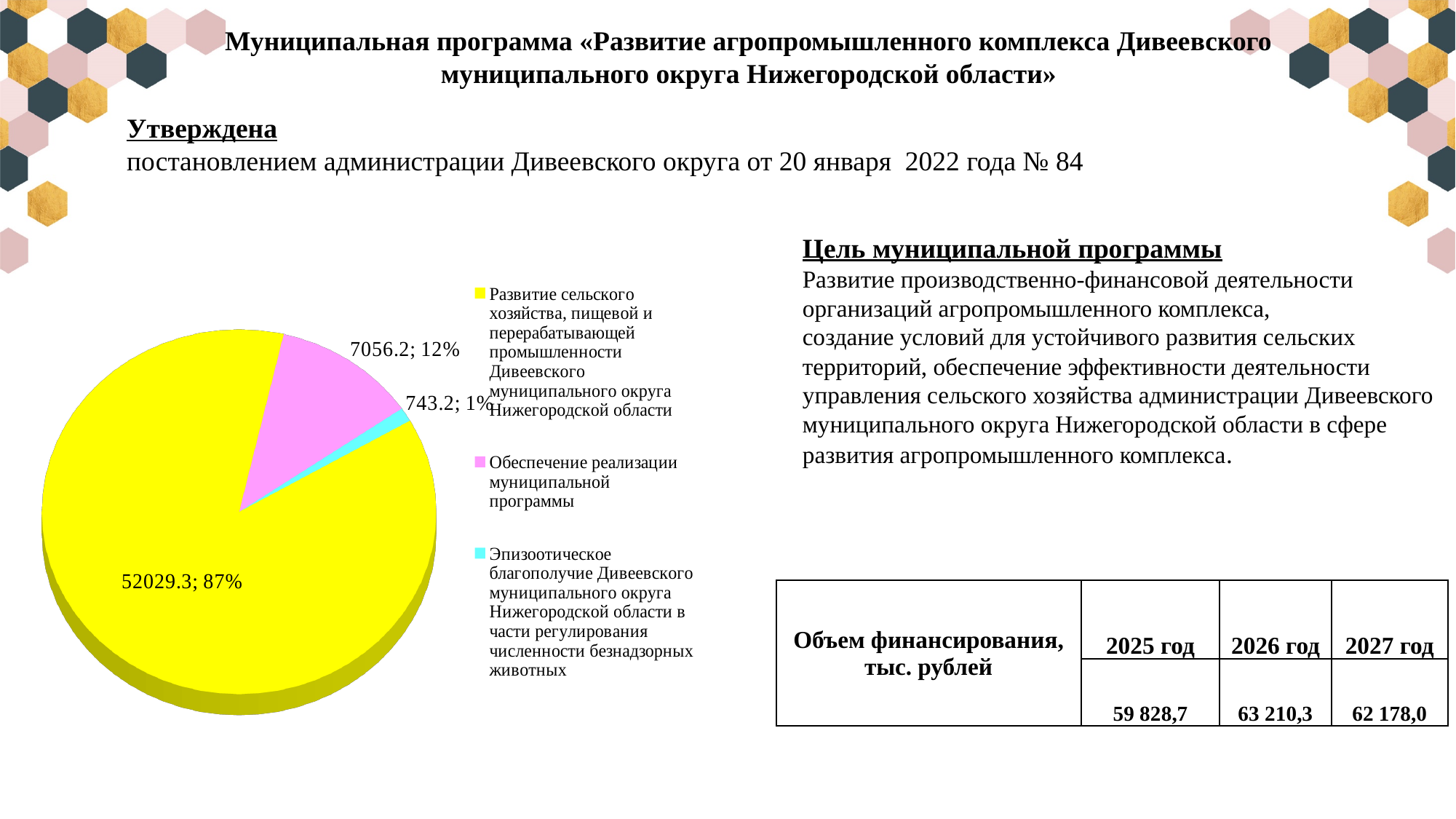
Каким цветом на круговой диаграмме показан сектор «Обеспечение реализации муниципальной программы»? розовым Какой тип диаграммы показан на слайде? круговая диаграмма Какая категория имеет наименьшее значение на круговой диаграмме? Эпизоотическое благополучие Дивеевского муниципального округа Нижегородской области в части регулирования численности безнадзорных животных Какое значение указано для сектора «Обеспечение реализации муниципальной программы»? 7056.2 Какую долю круговой диаграммы занимает сектор «Обеспечение реализации муниципальной программы»? 12% Какое значение указано для сектора «Развитие сельского хозяйства, пищевой и перерабатывающей промышленности Дивеевского муниципального округа Нижегородской области»? 52029.3 Какое значение указано для сектора «Эпизоотическое благополучие Дивеевского муниципального округа Нижегородской области в части регулирования численности безнадзорных животных»? 743.2 Какую долю круговой диаграммы занимает сектор «Развитие сельского хозяйства, пищевой и перерабатывающей промышленности Дивеевского муниципального округа Нижегородской области»? 87% На сколько значение сектора «Обеспечение реализации муниципальной программы» больше значения сектора «Эпизоотическое благополучие ... безнадзорных животных»? 6313.0 Какая категория имеет наибольшее значение на круговой диаграмме? Развитие сельского хозяйства, пищевой и перерабатывающей промышленности Дивеевского муниципального округа Нижегородской области Сколько записей содержит легенда круговой диаграммы? 3 Сколько секторов (категорий) содержит круговая диаграмма? 3